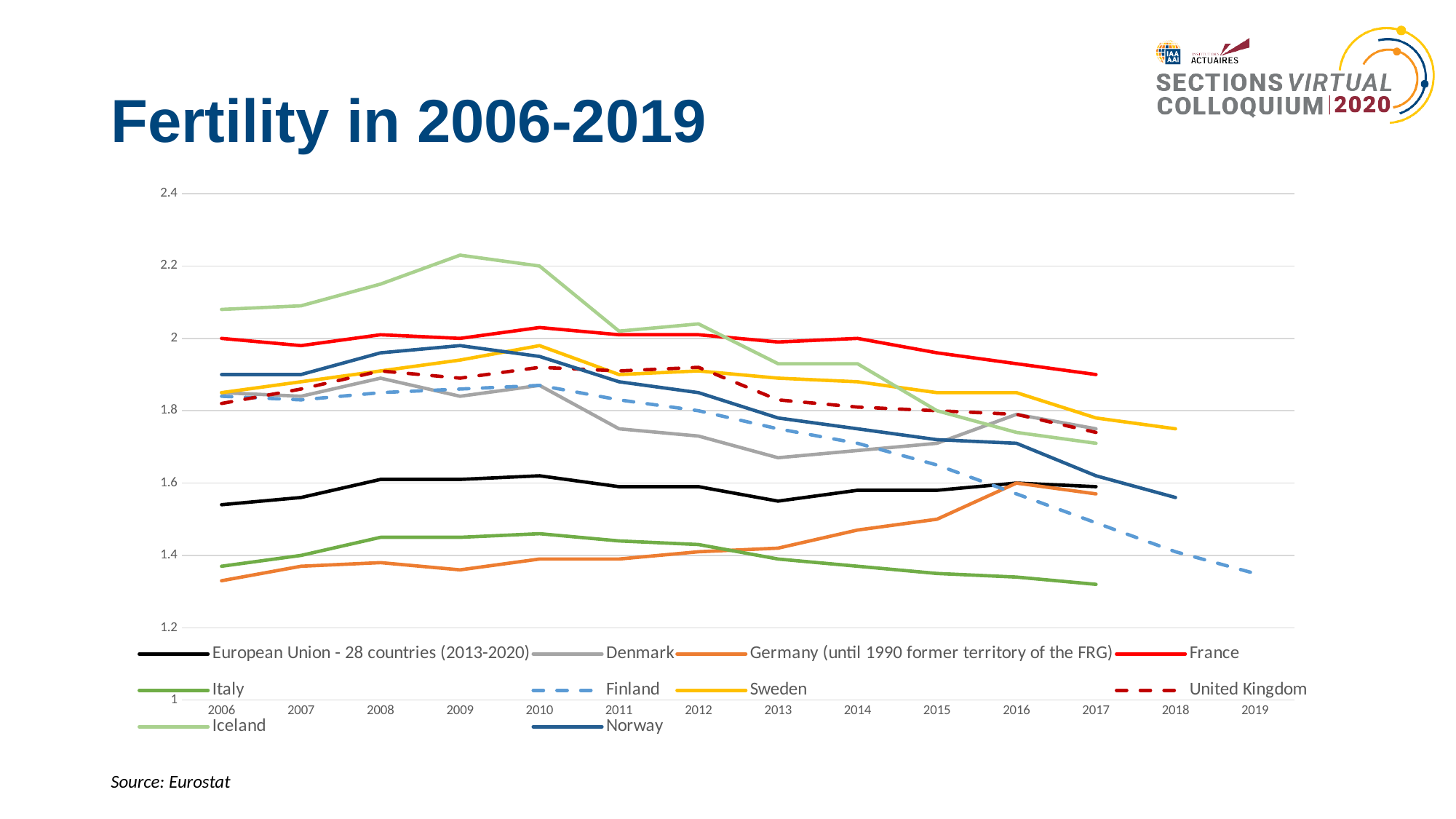
Does the value for Italy rise or fall from 2010 to 2017? fall Is the value for Finland in 2019 greater or less than 1.4? less How many years are shown on the x axis? 14 How many series does the legend list? 10 Which is larger in 2010, the value for France or the value for Italy? France What is the title of the chart? Fertility in 2006-2019 Which series has the lowest value in 2006? Germany (until 1990 former territory of the FRG) Does the value for Finland rise or fall from 2010 to 2019? fall Which series has the highest value in 2009? Iceland Is the value for Iceland in 2009 greater or less than 2? greater Is the value for France in 2017 greater or less than 1.8? greater What kind of chart is shown on the slide? line chart